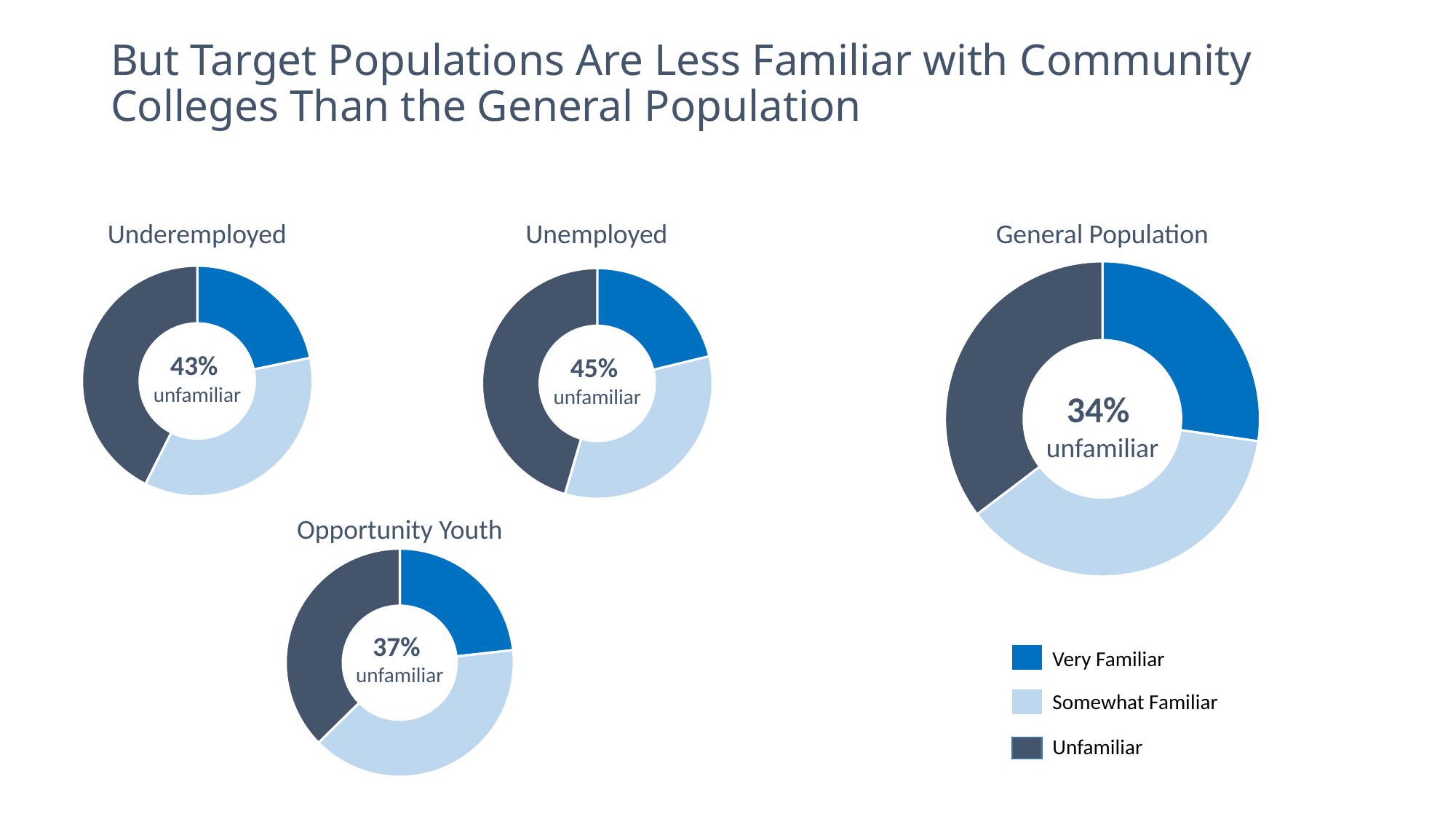
In the Unemployed chart, what percentage is unfamiliar? 45% What is the difference between the unfamiliar percentage in the Unemployed chart and the General Population chart? 11 percentage points In the Underemployed chart, what percentage is unfamiliar with community colleges? 43% Across the four charts, which population has the lowest unfamiliar percentage? General Population Which has a larger unfamiliar percentage, the Underemployed chart or the Opportunity Youth chart? Underemployed How many categories does the legend list? 3 In the General Population chart, what percentage is unfamiliar? 34% In the Opportunity Youth chart, what percentage is unfamiliar? 37% How many donut charts are shown on the slide? 4 Across the four charts, which population has the highest unfamiliar percentage? Unemployed Which legend category is shown in the darkest colour? Unfamiliar What kind of chart is used for the Underemployed data? Pie (donut) chart